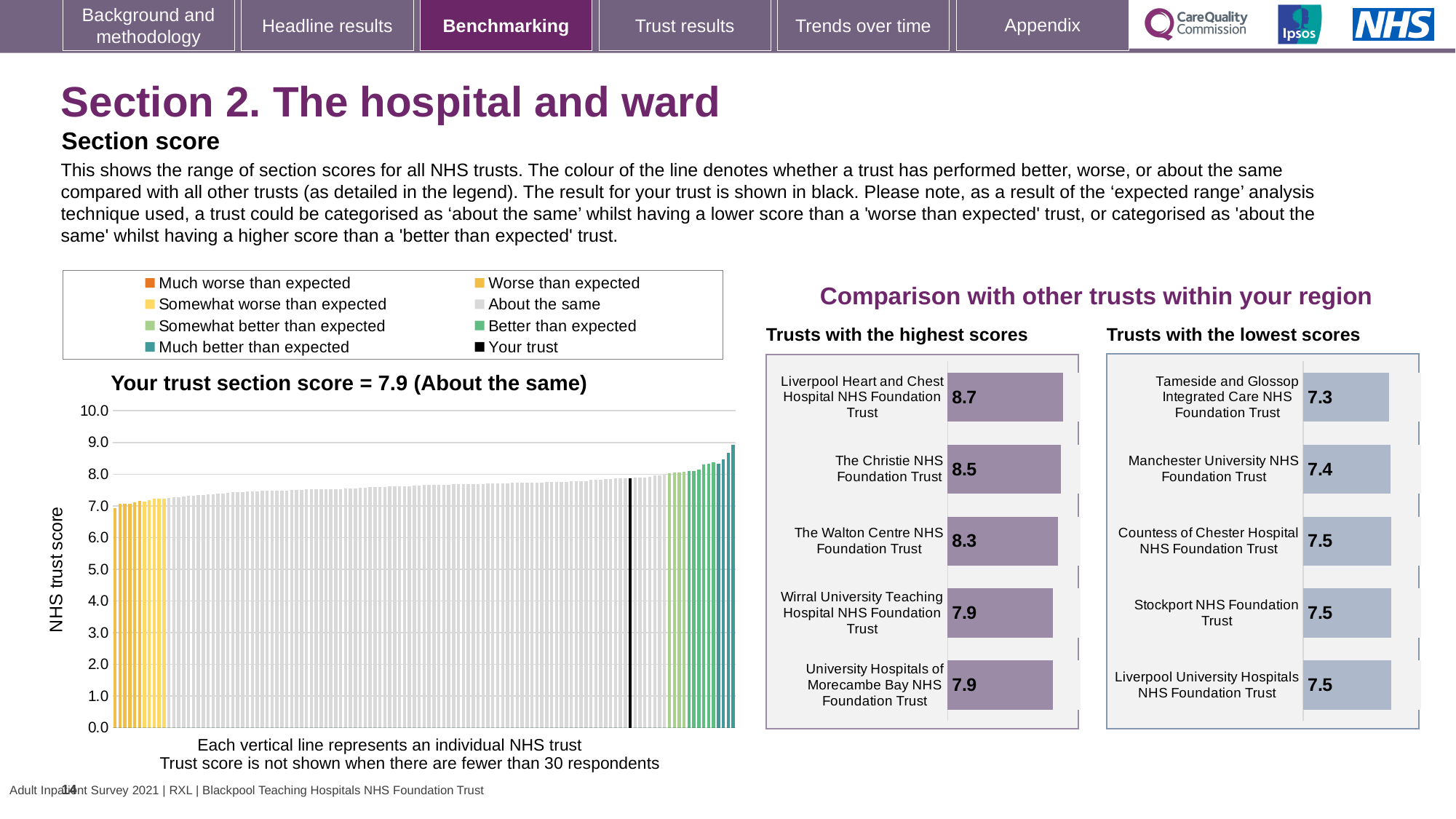
In the 'Your trust section score' chart on the left, what kind of chart is it? Bar chart Which score is larger: The Christie NHS Foundation Trust in the highest scores chart or Manchester University NHS Foundation Trust in the lowest scores chart? The Christie NHS Foundation Trust In the 'Trusts with the lowest scores' chart, what is the difference between the scores of Stockport NHS Foundation Trust and Tameside and Glossop Integrated Care NHS Foundation Trust? 0.2 In the 'Trusts with the highest scores' chart, how many trusts are shown? 5 How many entries does the legend above the left-hand chart list? 8 In the 'Trusts with the highest scores' chart, which trust has the highest score? Liverpool Heart and Chest Hospital NHS Foundation Trust In the 'Your trust section score' chart on the left, do the trust scores rise or fall from left to right? Rise In the 'Trusts with the highest scores' chart, what is the score for The Christie NHS Foundation Trust? 8.5 In the 'Trusts with the highest scores' chart, what is the difference between the scores of Liverpool Heart and Chest Hospital NHS Foundation Trust and The Walton Centre NHS Foundation Trust? 0.4 In the 'Trusts with the lowest scores' chart, what is the score for Manchester University NHS Foundation Trust? 7.4 In the 'Trusts with the lowest scores' chart, which trust has the lowest score? Tameside and Glossop Integrated Care NHS Foundation Trust According to the title of the chart on the left, what is your trust's section score? 7.9